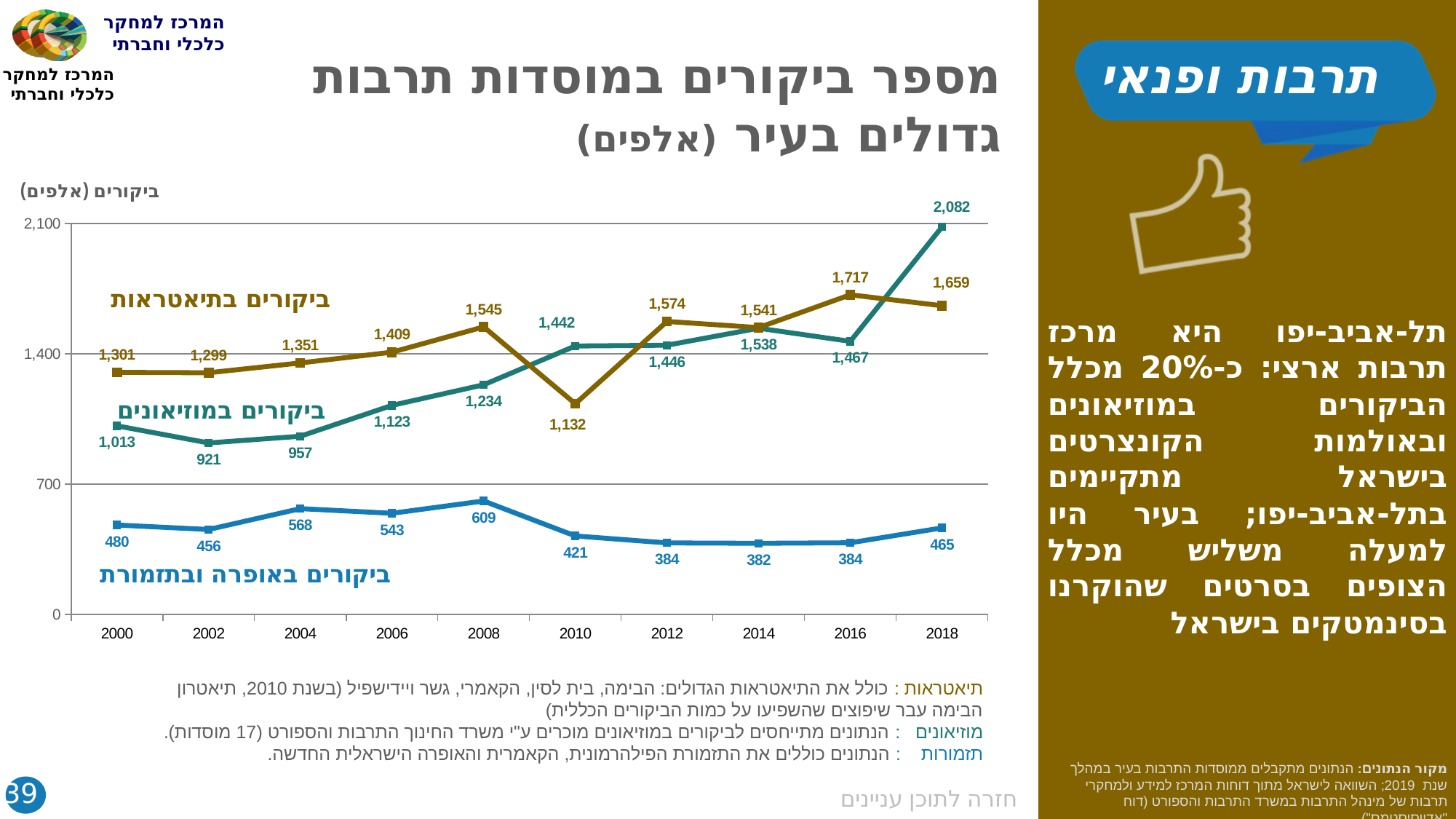
What is the value for theater visits (ביקורים בתיאטראות) in 2010? 1,132 What is the difference between museum visits and theater visits in 2018? 423 In which year is the value for theater visits (ביקורים בתיאטראות) highest? 2016 Is the value for opera and orchestra visits (ביקורים באופרה ובתזמורת) in 2014 greater or less than 700? less What is the value for opera and orchestra visits (ביקורים באופרה ובתזמורת) in 2008? 609 What is the value for museum visits (ביקורים במוזיאונים) in 2018? 2,082 What is the label of the y axis of the chart? ביקורים (אלפים) Which is larger in 2012: theater visits (ביקורים בתיאטראות) or museum visits (ביקורים במוזיאונים)? theater visits (ביקורים בתיאטראות) How many years are shown on the x axis of the chart? 10 How many series are plotted in the chart? 3 In which year is the value for museum visits (ביקורים במוזיאונים) lowest? 2002 What kind of chart is shown on the slide? line chart